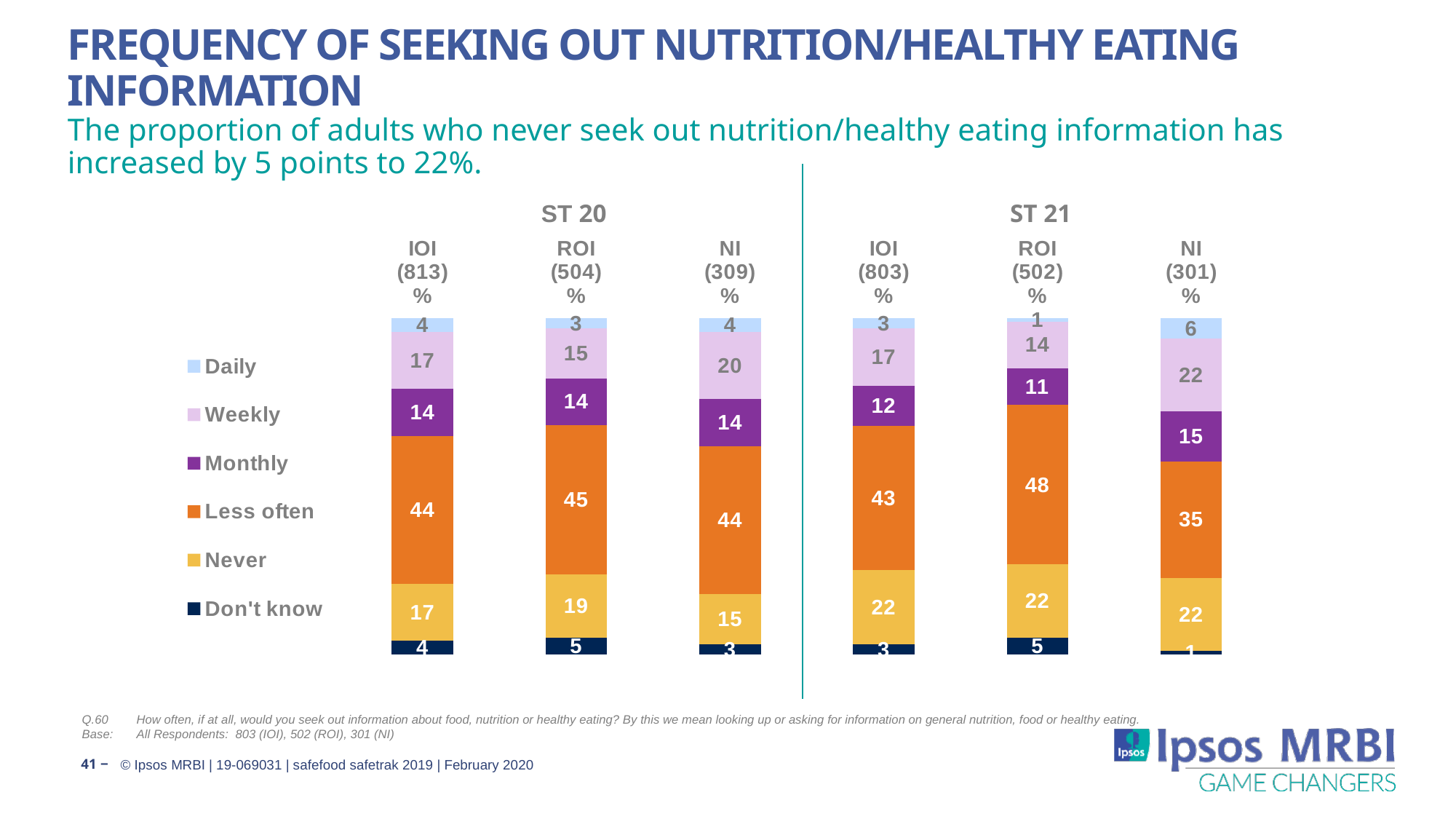
What is the 'Weekly' value for NI in ST 20? 20 How many bars are plotted in the chart? 6 What is the 'Daily' value for ROI in ST 21? 1 How many series does the legend list? 6 Which is larger: the 'Monthly' value for NI in ST 21 or for ROI in ST 21? NI in ST 21 What is the 'Never' value for IOI in ST 21? 22 What is the difference between the 'Never' value for IOI in ST 21 and IOI in ST 20? 5 Which bar has the lowest 'Less often' value? NI (ST 21) What kind of chart is shown on the slide? Stacked bar chart What is the 'Less often' value for ROI in ST 21? 48 Which legend entry is shown in orange? Less often Which bar has the highest 'Less often' value? ROI (ST 21)